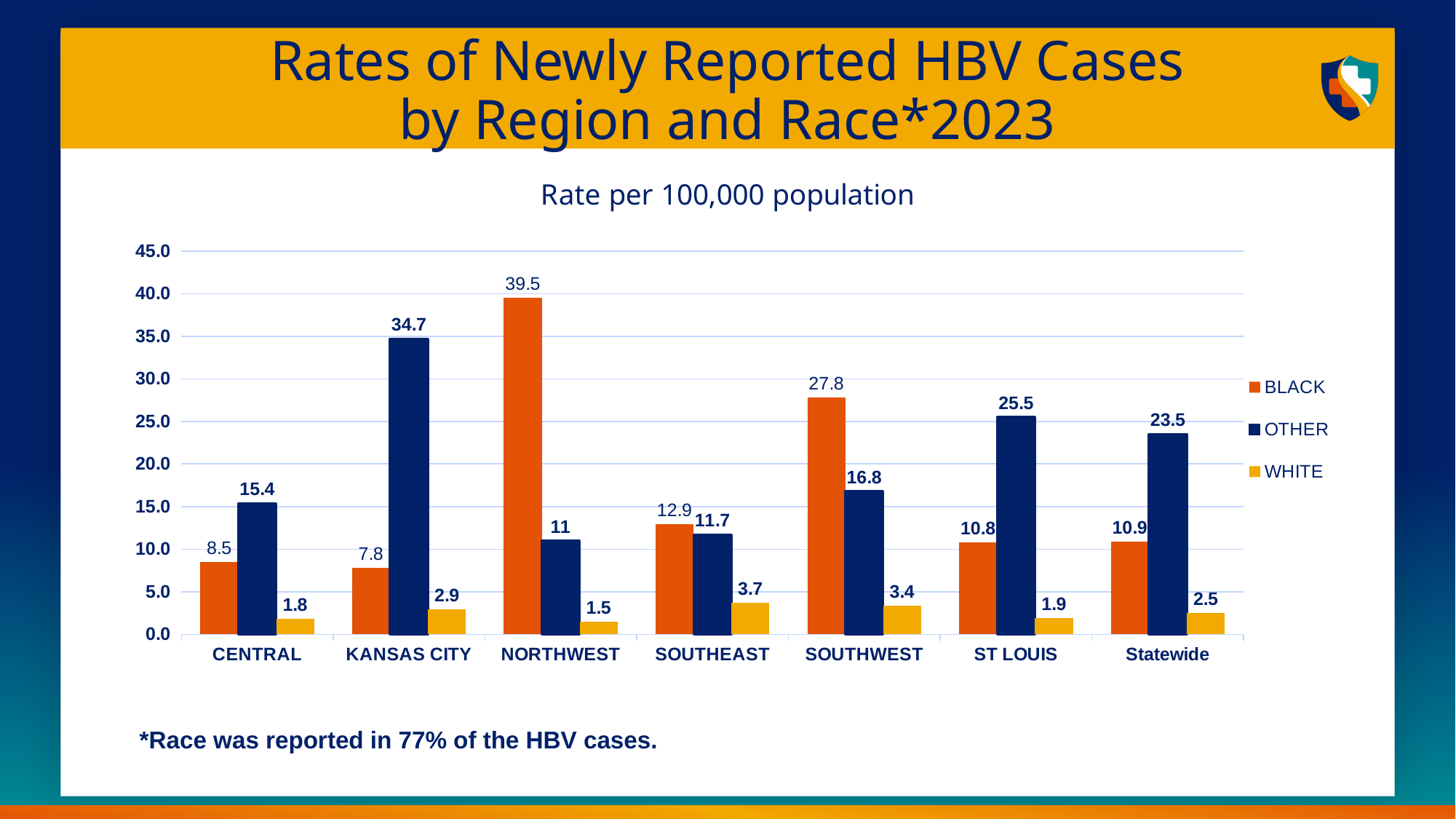
What is the difference between the BLACK and OTHER rates in the SOUTHWEST region? 11 How many regions (categories) are shown on the x axis? 7 Which region has the highest rate for BLACK? NORTHWEST What is the rate for WHITE in the SOUTHEAST region? 3.7 Which region has the lowest rate for WHITE? NORTHWEST What unit is the rate expressed in, according to the chart subtitle? Rate per 100,000 population Which is larger in ST LOUIS, the rate for BLACK or the rate for OTHER? OTHER What is the Statewide rate for OTHER? 23.5 What is the rate for BLACK in the NORTHWEST region? 39.5 How many series does the legend list? 3 What kind of chart is shown on the slide? Bar chart What is the rate for OTHER in KANSAS CITY? 34.7